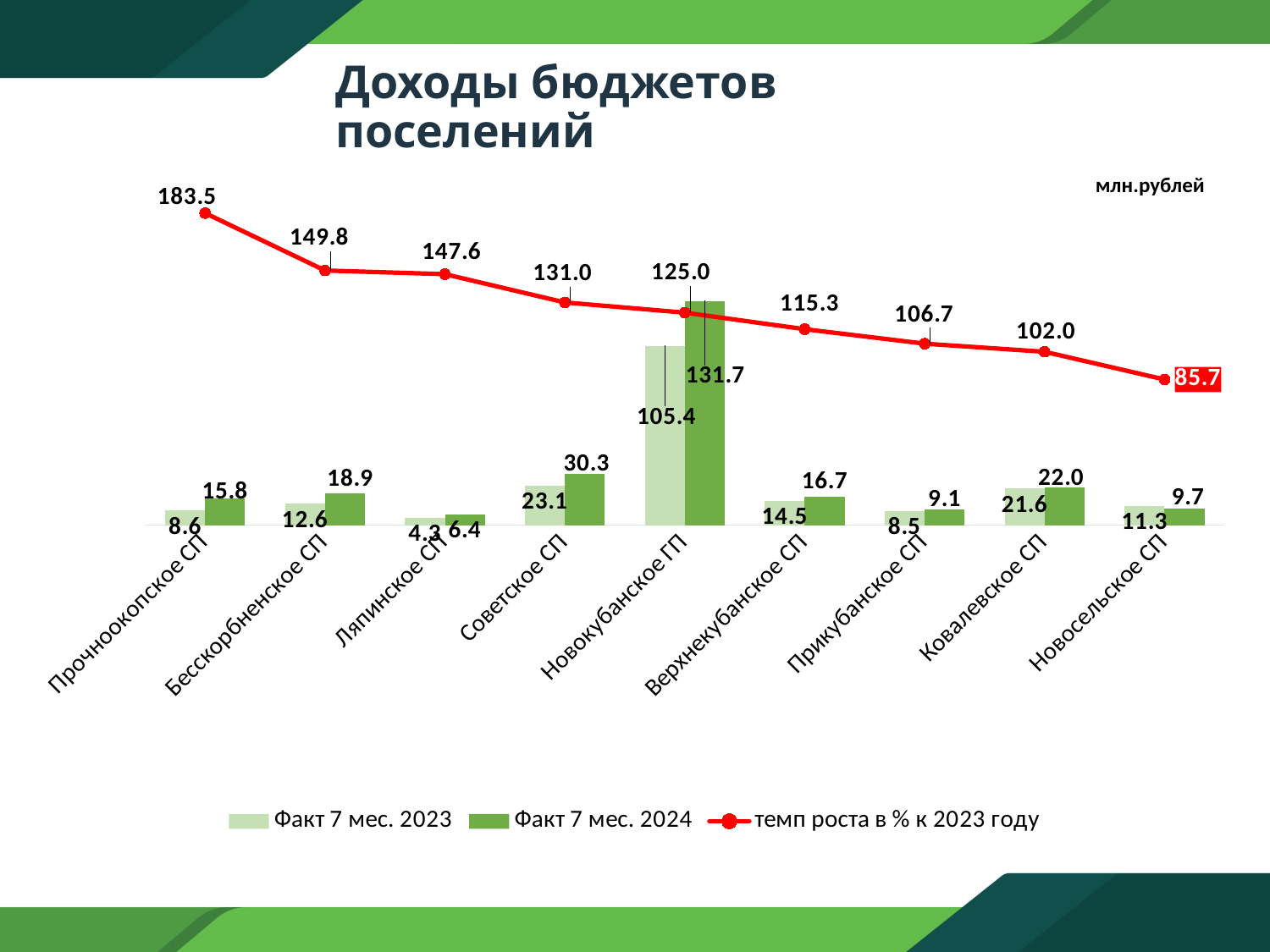
What is the Факт 7 мес. 2024 value for Советское СП? 30.3 Does the темп роста в % к 2023 году line rise or fall from left to right across the categories? fall How many categories are shown on the x axis? 9 What unit is indicated in the top right of the chart? млн.рублей What is the Факт 7 мес. 2023 value for Новокубанское ГП? 105.4 How many series does the legend list? 3 Which category has the lowest темп роста в % к 2023 году value? Новосельское СП Which category has the lowest Факт 7 мес. 2023 value? Ляпинское СП Which is larger for Новосельское СП: the Факт 7 мес. 2023 value or the Факт 7 мес. 2024 value? Факт 7 мес. 2023 What is the темп роста в % к 2023 году value for Прочноокопское СП? 183.5 Which category has the highest Факт 7 мес. 2024 value? Новокубанское ГП What is the difference between the Факт 7 мес. 2024 and Факт 7 мес. 2023 values for Ковалевское СП? 0.4